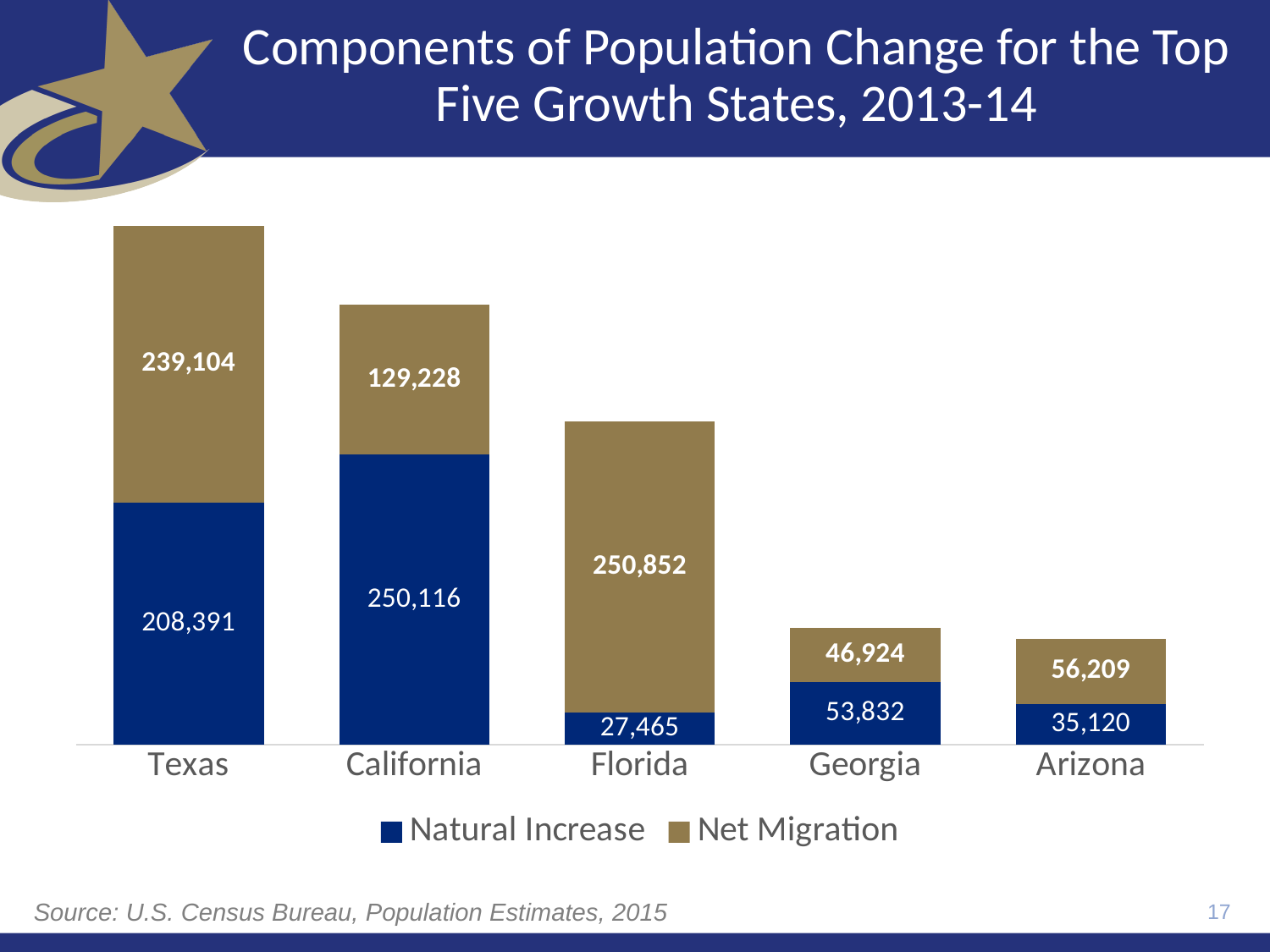
How many states are shown on the chart? 5 What is the total population change (Natural Increase plus Net Migration) for Arizona? 91,329 What is the Natural Increase value for Florida? 27,465 Which state has the highest Natural Increase? California What is the difference between Net Migration and Natural Increase for Texas? 30,713 Which series is shown in dark blue in the legend? Natural Increase What kind of chart is shown on the slide? Stacked bar chart Which state has the highest Net Migration? Florida How many series does the legend list? 2 What is the Net Migration value for Texas? 239,104 Which state has the lowest Net Migration? Georgia For Georgia, which is larger: Natural Increase or Net Migration? Natural Increase